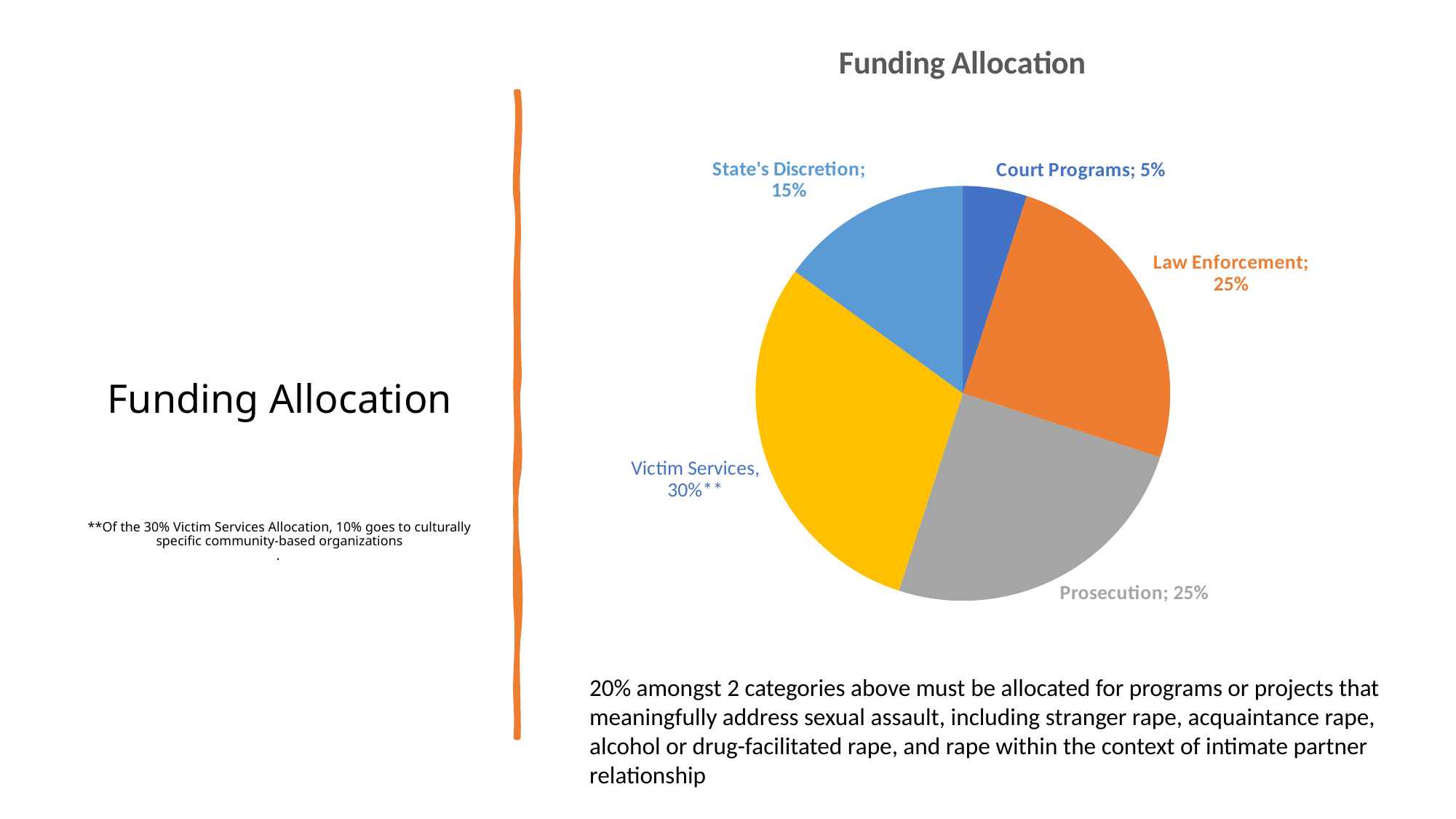
What percentage of funding is allocated to Victim Services? 30% What percentage of funding is allocated to Court Programs? 5% What kind of chart is shown on the slide? Pie chart Which receives more funding, Law Enforcement or Court Programs? Law Enforcement What colour is the Prosecution slice? Grey Which category receives the largest share of funding? Victim Services What percentage of funding is allocated to State's Discretion? 15% How many categories are shown in the pie chart? 5 Which category receives the smallest share of funding? Court Programs What is the difference between the Victim Services share and the State's Discretion share? 15% What is the title of the chart? Funding Allocation What percentage of funding is allocated to Law Enforcement? 25%